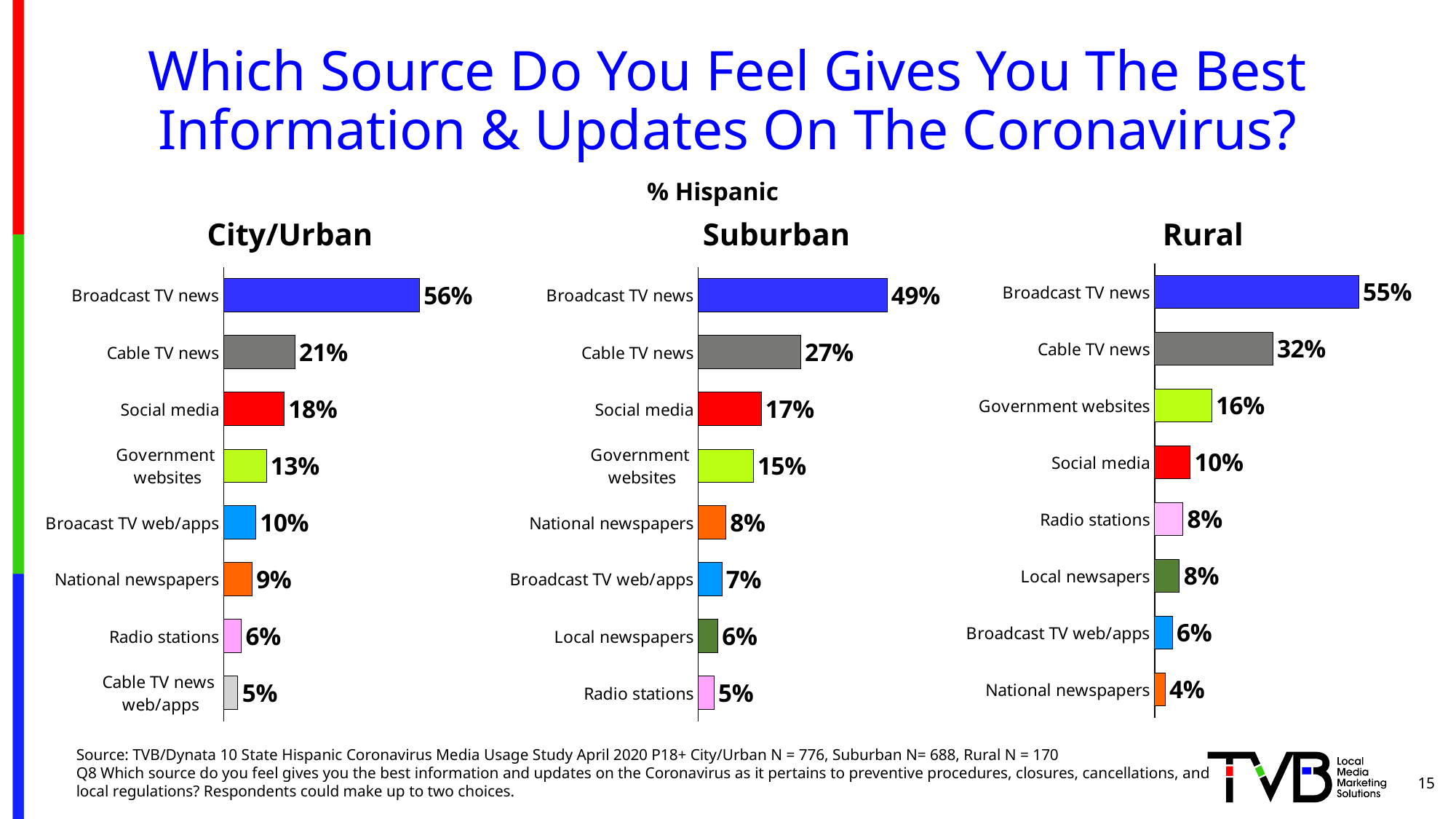
In the City/Urban chart, what is the value for Broadcast TV news? 56% In the City/Urban chart, what is the difference between Broadcast TV news and Cable TV news? 35% In the Rural chart, what is the value for Government websites? 16% What type of chart is the Suburban chart? Bar chart What is the subtitle shown above the three charts? % Hispanic In the Suburban chart, which is larger: Social media or Government websites? Social media How many categories are shown in the City/Urban chart? 8 In the City/Urban chart, what is the value for Cable TV news web/apps? 5% In the Rural chart, which category has the highest value? Broadcast TV news In the Suburban chart, which category has the lowest value? Radio stations In the Rural chart, what is the difference between Cable TV news and Social media? 22% In the Suburban chart, what is the value for Cable TV news? 27%